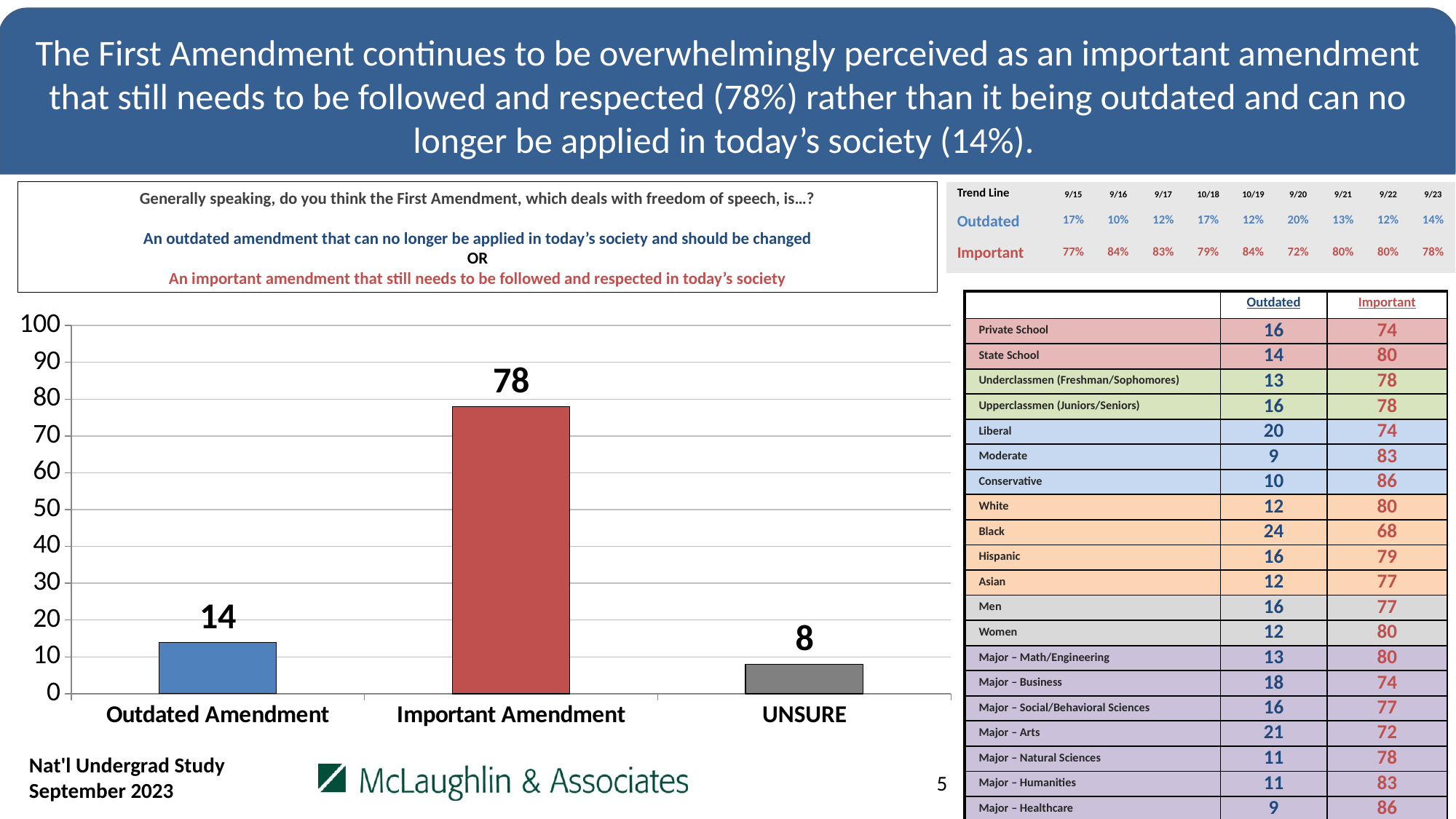
What is the difference between the Outdated Amendment and UNSURE values in the bar chart? 6 What is the value for UNSURE in the bar chart? 8 What is the value for Outdated Amendment in the bar chart? 14 Which is larger in the bar chart, Outdated Amendment or UNSURE? Outdated Amendment What kind of chart is shown on the slide? bar chart How many categories are shown in the bar chart? 3 What colour is the Important Amendment bar in the bar chart? red Which category has the highest value in the bar chart? Important Amendment What is the value for Important Amendment in the bar chart? 78 Is the value for Important Amendment in the bar chart greater or less than 70? greater What is the difference between the Important Amendment and Outdated Amendment values in the bar chart? 64 Which category has the lowest value in the bar chart? UNSURE